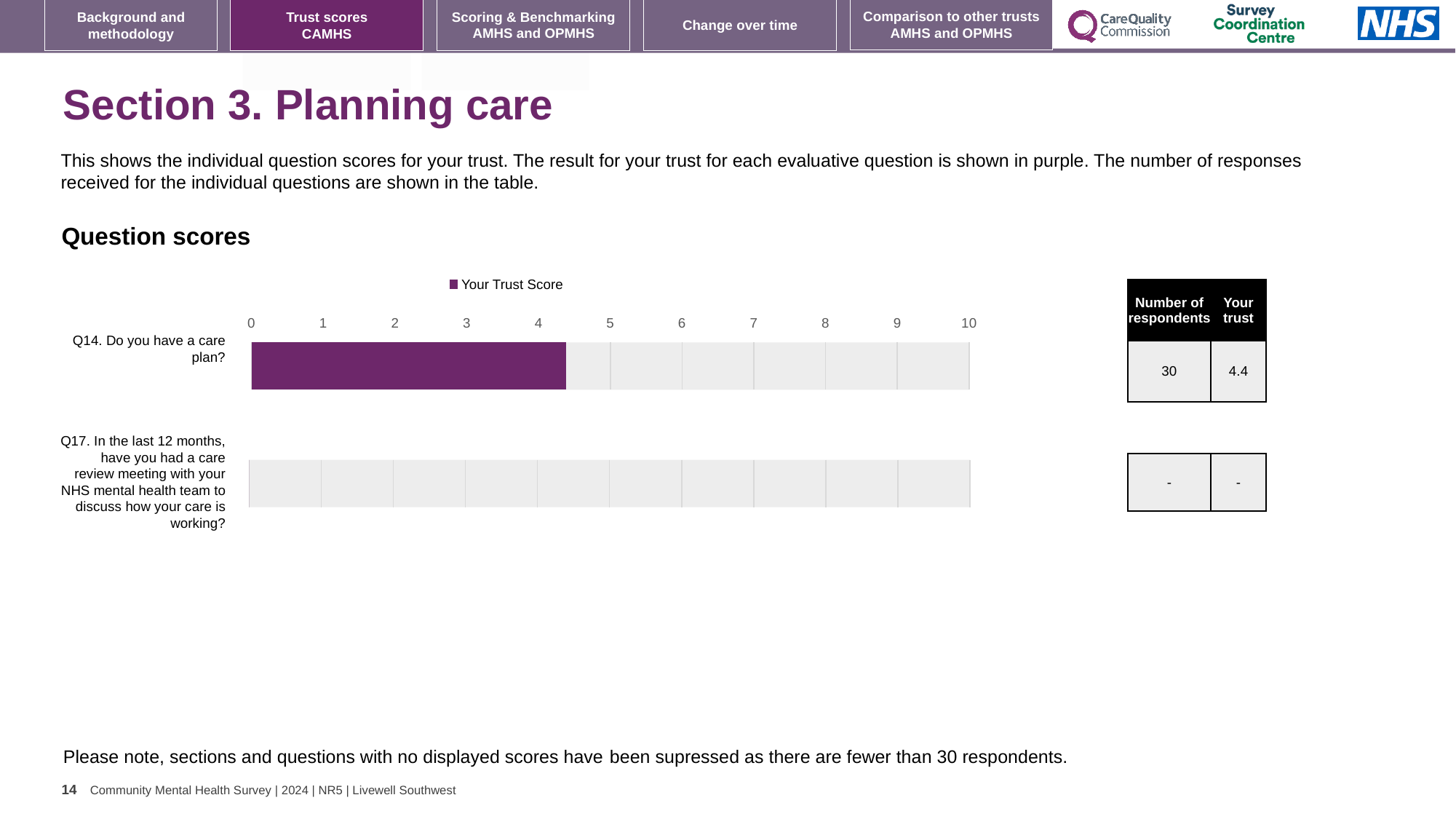
Which question on the Question scores chart has no displayed score? Q17 How many questions (categories) are plotted on the Question scores chart? 2 What is the name of the series shown in the legend of the Question scores chart? Your Trust Score What kind of chart is shown under 'Question scores'? bar chart What is the maximum value shown on the x axis of the Question scores chart? 10 Is the trust score for Q14 'Do you have a care plan?' greater or less than 4? greater How many series does the legend of the Question scores chart list? 1 Is the trust score for Q14 'Do you have a care plan?' greater or less than 5? less Which question on the Question scores chart has the highest displayed trust score? Q14 What is the trust score for Q14 'Do you have a care plan?'? 4.4 How many respondents answered Q14 according to the table next to the chart? 30